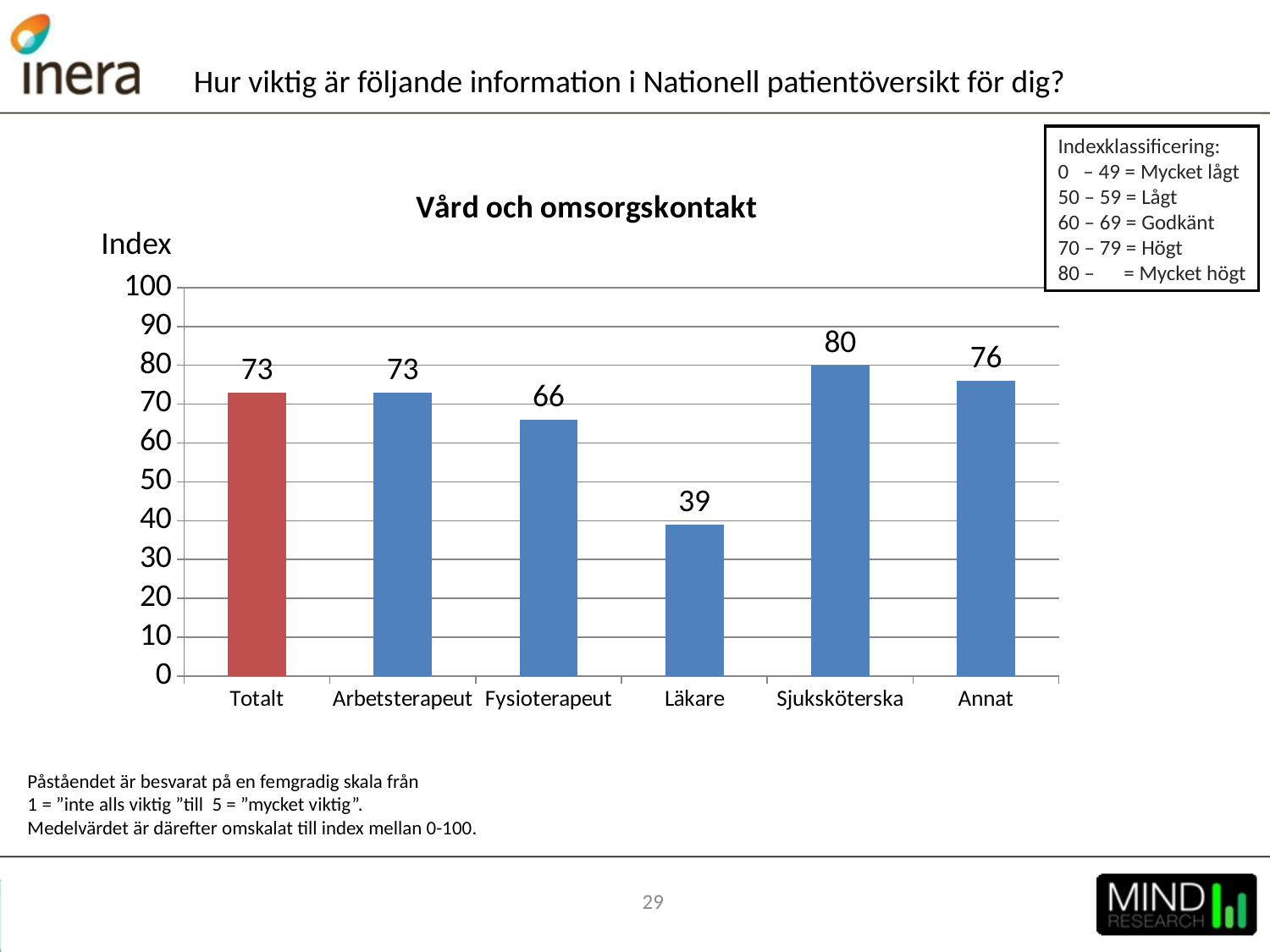
What is the index value for Fysioterapeut? 66 What is the index value for Läkare in the Vård och omsorgskontakt chart? 39 Which category has the lowest index value? Läkare What is the title of the chart? Vård och omsorgskontakt How many categories are shown on the x axis of the chart? 6 What is the index value for Totalt? 73 Which category has the highest index value? Sjuksköterska What is the difference between the index values for Sjuksköterska and Läkare? 41 Which has a higher index value, Annat or Arbetsterapeut? Annat What kind of chart is shown on the slide? Bar chart What is the index value for Sjuksköterska? 80 What is the difference between the index values for Annat and Fysioterapeut? 10